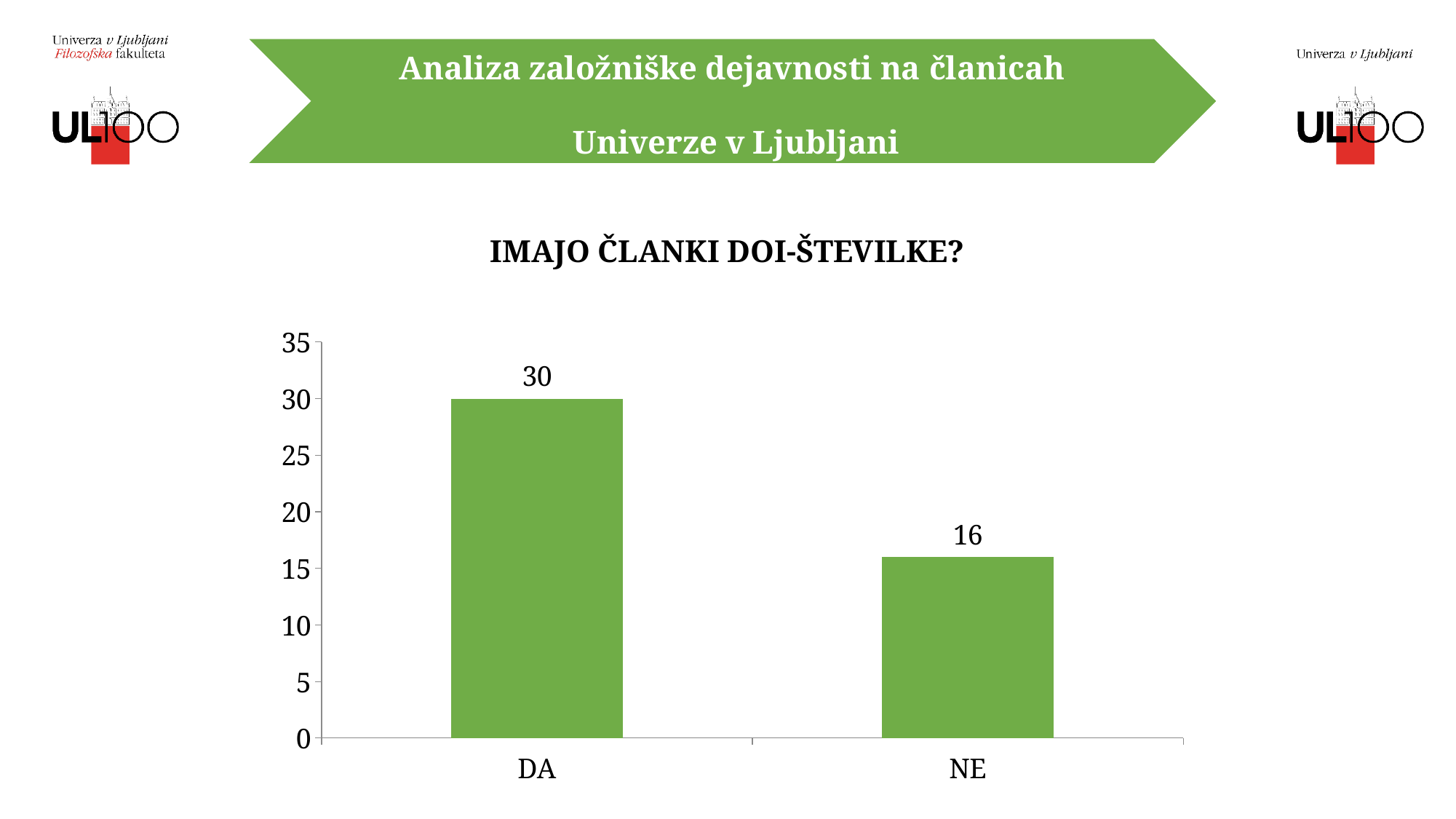
Is the value for NE greater or less than 20? less Is the value for DA greater or less than 25? greater What is the title of the chart? IMAJO ČLANKI DOI-ŠTEVILKE? What kind of chart is shown on the slide? bar chart Which category has the highest value? DA What is the difference between the values for DA and NE? 14 How many categories are shown on the chart? 2 Which category has the lowest value? NE What is the value for NE? 16 What is the value for DA? 30 What is the total of the values for DA and NE? 46 Which is larger, the value for DA or the value for NE? DA